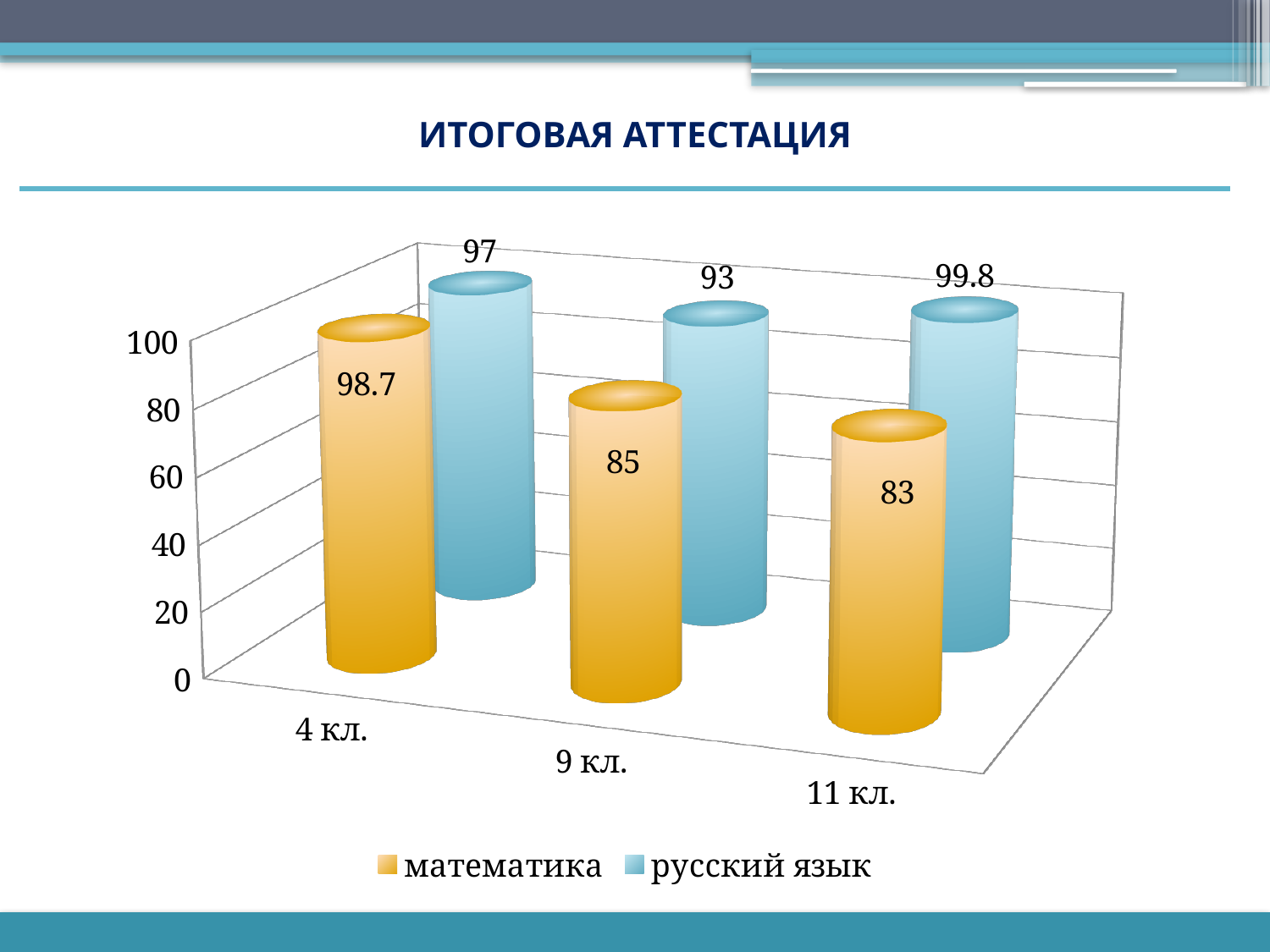
How many classes are shown on the x axis? 3 What is the value for русский язык in 9 кл.? 93 Which class has the lowest value for математика? 11 кл. Which class has the highest value for русский язык? 11 кл. Do the математика values rise or fall from 4 кл. to 11 кл.? fall What is the value for русский язык in 11 кл.? 99.8 How many series does the legend list? 2 What kind of chart is shown on the slide? bar chart What is the value for математика in 9 кл.? 85 Which is larger in 9 кл., математика or русский язык? русский язык What is the value for математика in 4 кл.? 98.7 What is the difference between the русский язык and математика values in 11 кл.? 16.8